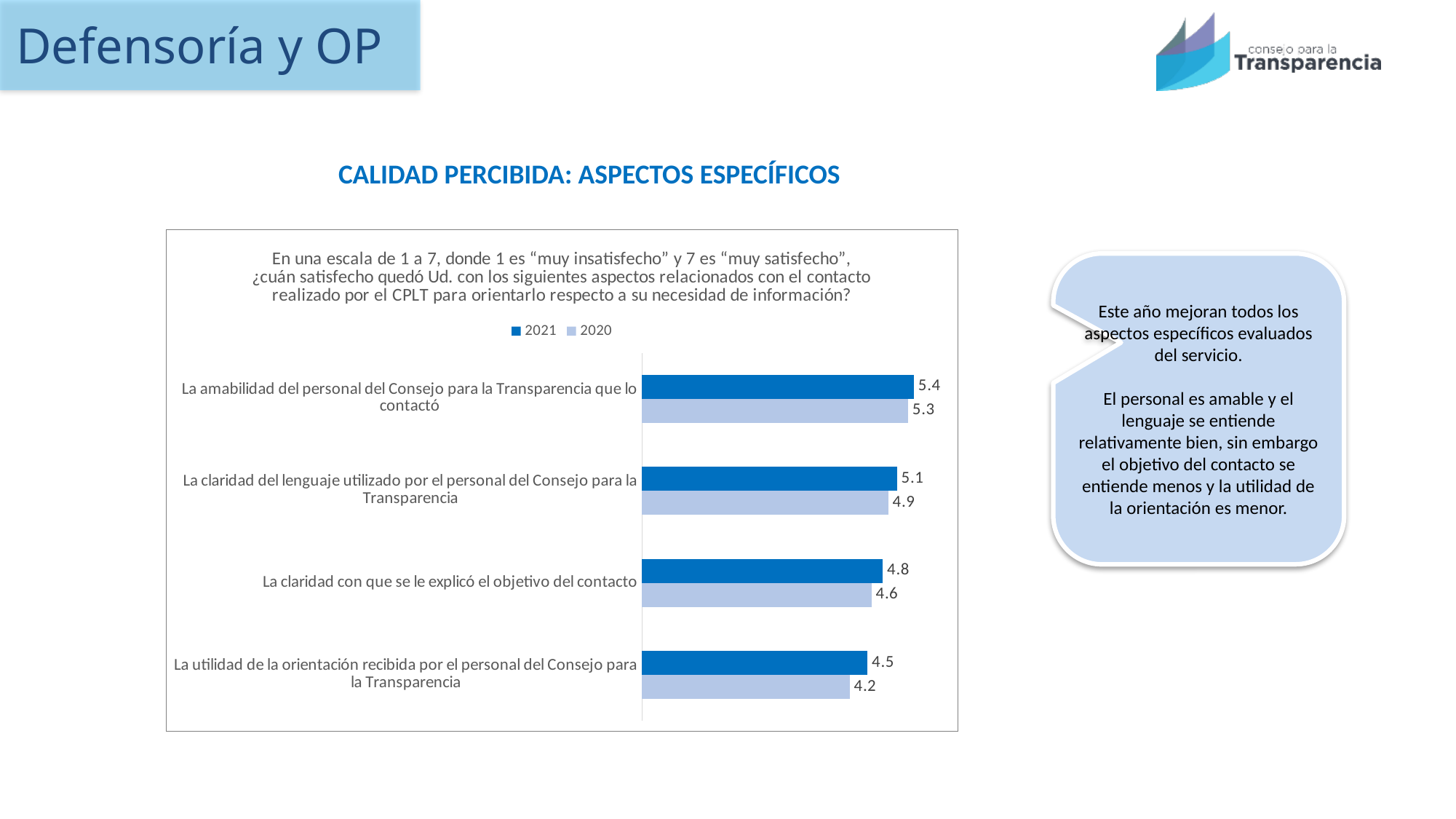
What is the 2020 value for 'La claridad del lenguaje utilizado por el personal del Consejo para la Transparencia'? 4.9 Which series is shown in the darker blue colour? 2021 What is the difference between the 2021 and 2020 values for 'La utilidad de la orientación recibida por el personal del Consejo para la Transparencia'? 0.3 Which aspect has the highest 2021 value? La amabilidad del personal del Consejo para la Transparencia que lo contactó How many series does the legend list? 2 What is the 2020 value for 'La utilidad de la orientación recibida por el personal del Consejo para la Transparencia'? 4.2 What is the 2021 value for 'La amabilidad del personal del Consejo para la Transparencia que lo contactó'? 5.4 What is the 2021 value for 'La claridad con que se le explicó el objetivo del contacto'? 4.8 How many aspects (categories) are shown in the chart? 4 Which aspect has the lowest 2020 value? La utilidad de la orientación recibida por el personal del Consejo para la Transparencia What type of chart is shown on the slide? Bar chart Which is larger for 'La claridad con que se le explicó el objetivo del contacto': the 2021 value or the 2020 value? 2021